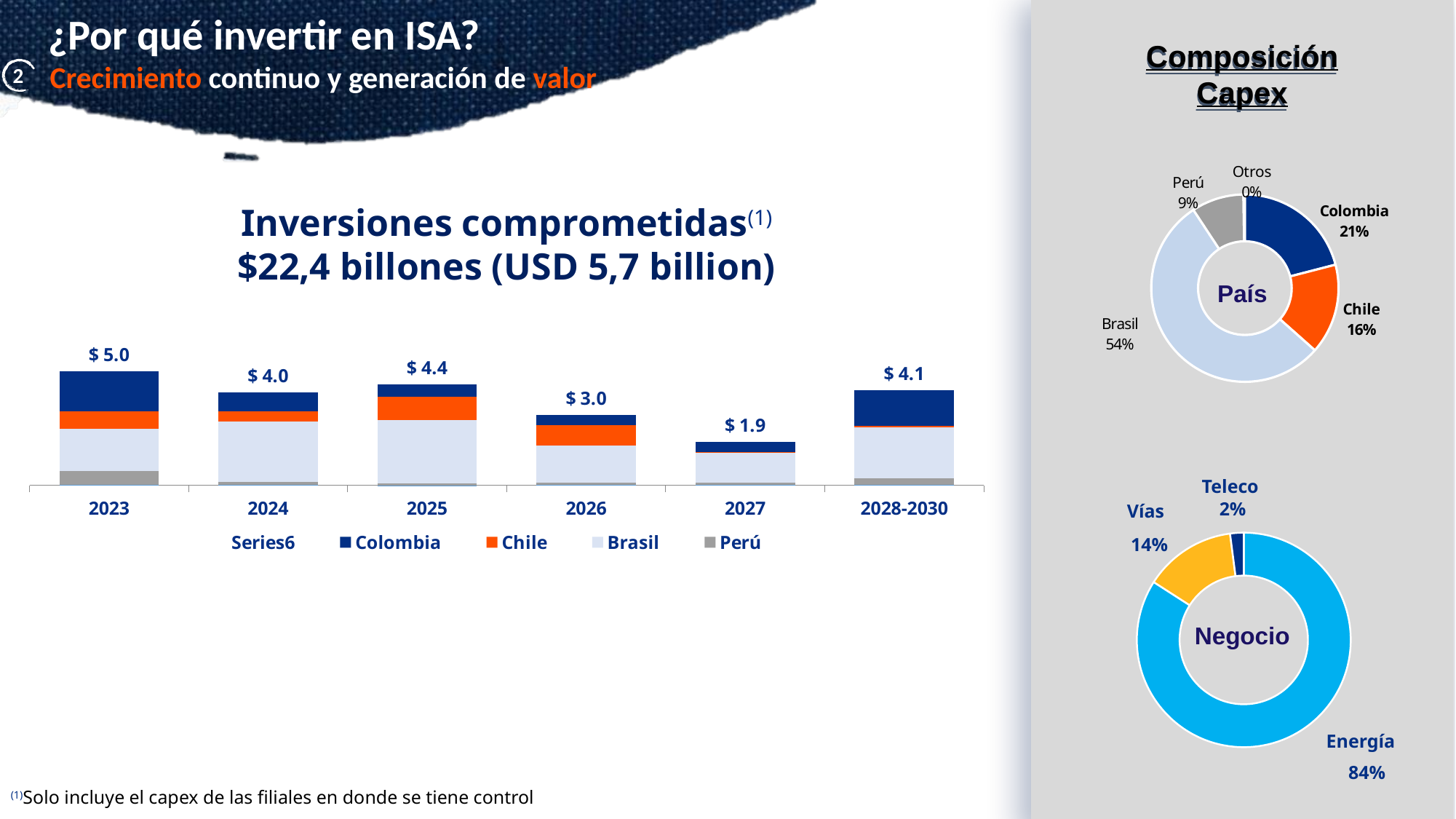
What kind of chart is 'Inversiones comprometidas'? Stacked bar chart In the 'Inversiones comprometidas' bar chart, what is the difference between the 2023 total and the 2027 total? $ 3.1 In the 'Inversiones comprometidas' bar chart, which period has the highest total? 2023 In the 'Negocio' doughnut chart, what share does Vías have? 14% In the 'Inversiones comprometidas' bar chart, which total is larger, 2024 or 2025? 2025 How many periods are shown on the x axis of the 'Inversiones comprometidas' bar chart? 6 In the 'Inversiones comprometidas' bar chart, what is the total value labelled for 2023? $ 5.0 In the 'País' doughnut chart, what share does Brasil have? 54% In the 'Inversiones comprometidas' bar chart, which period has the lowest total? 2027 How many entries does the legend of the 'Inversiones comprometidas' chart list? 5 In the 'Inversiones comprometidas' bar chart, what is the total value labelled for 2028-2030? $ 4.1 In the 'País' doughnut chart, what is the difference between the Colombia and Chile shares? 5 percentage points